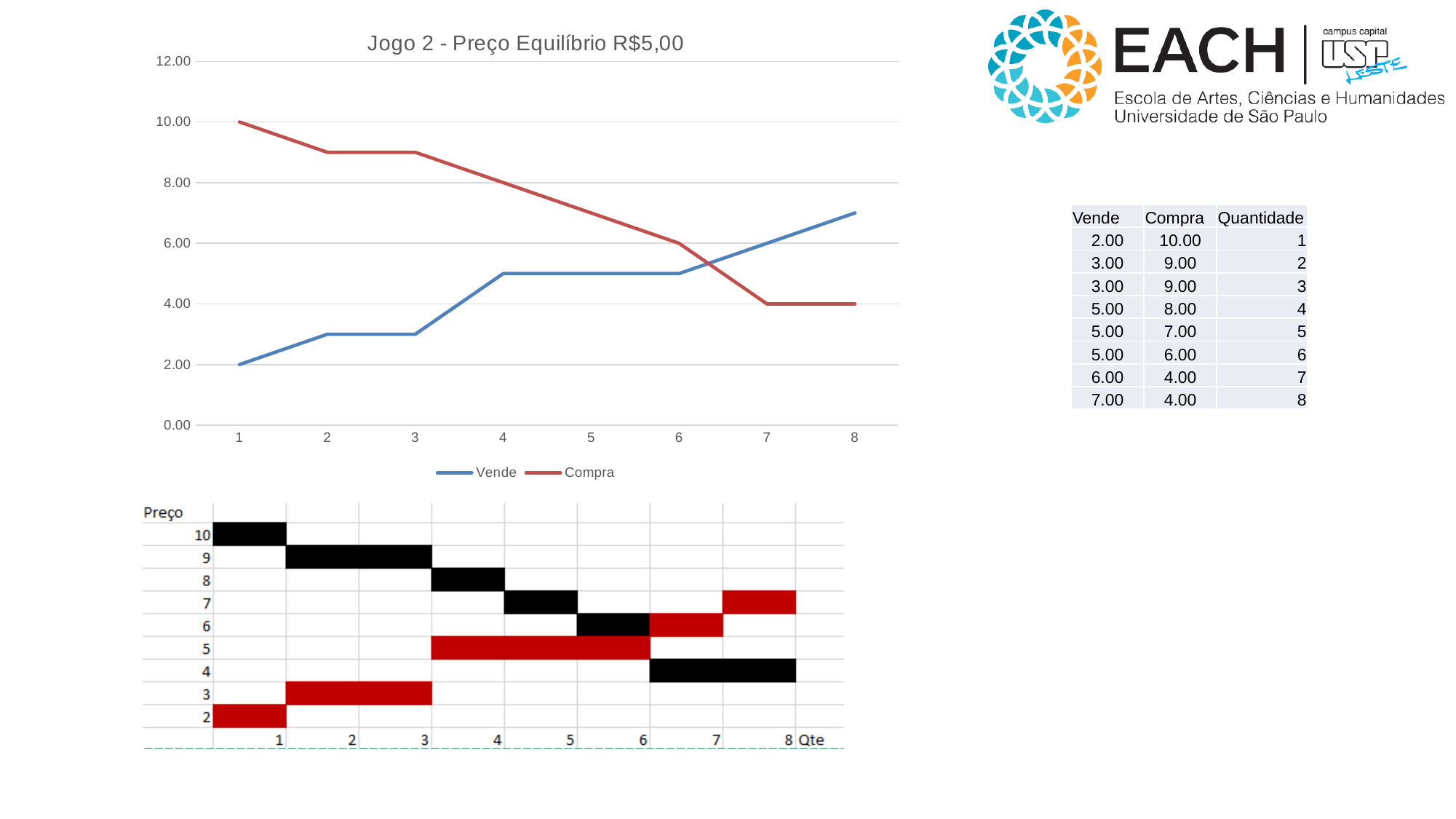
In the chart titled "Jogo 2 - Preço Equilíbrio R$5,00", what is the difference between Compra and Vende at x = 1? 8.00 In the chart titled "Jogo 2 - Preço Equilíbrio R$5,00", which series has the larger value at x = 7, Vende or Compra? Vende In the chart titled "Jogo 2 - Preço Equilíbrio R$5,00", at which x value is Vende lowest? 1 In the chart titled "Jogo 2 - Preço Equilíbrio R$5,00", what kind of chart is shown? Line chart In the chart titled "Jogo 2 - Preço Equilíbrio R$5,00", what colour is the Vende line? Blue In the chart titled "Jogo 2 - Preço Equilíbrio R$5,00", does the Compra series rise or fall from x = 1 to x = 8? Fall In the chart titled "Jogo 2 - Preço Equilíbrio R$5,00", how many points are plotted along the x axis for each series? 8 In the chart titled "Jogo 2 - Preço Equilíbrio R$5,00", how many series does the legend list? 2 In the chart titled "Jogo 2 - Preço Equilíbrio R$5,00", at which x value is Compra lowest? 7 and 8 In the chart titled "Jogo 2 - Preço Equilíbrio R$5,00", what is the value of Compra at x = 1? 10.00 In the chart titled "Jogo 2 - Preço Equilíbrio R$5,00", what is the value of Vende at x = 8? 7.00 In the chart titled "Jogo 2 - Preço Equilíbrio R$5,00", what is the value of Vende at x = 4? 5.00